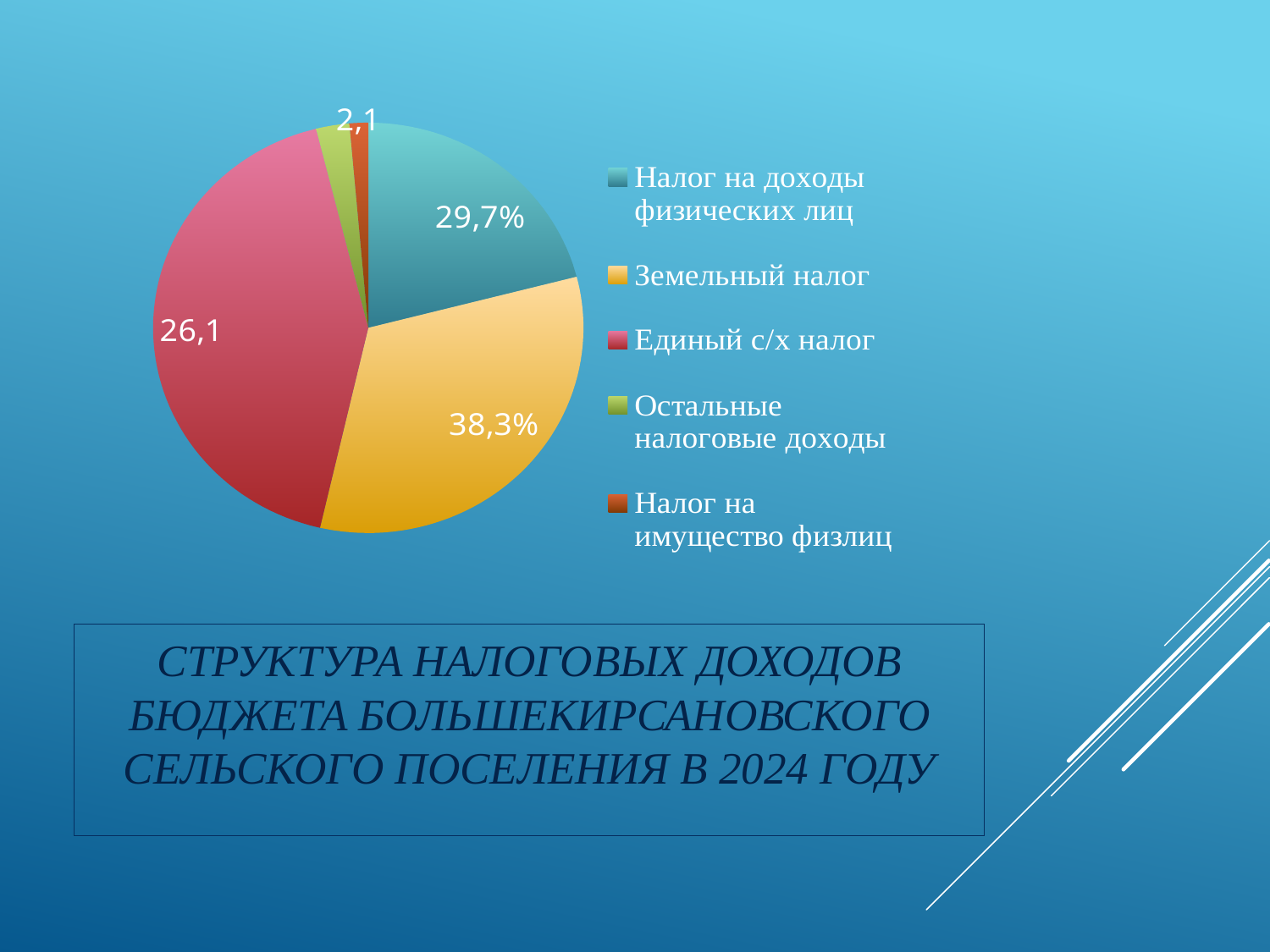
Which year does the chart title say the tax revenue structure refers to? 2024 Which category has the largest slice of the pie? Единый с/х налог What is the value shown for Налог на доходы физических лиц? 29,7% What kind of chart is shown on the slide? pie chart What is the value shown for Земельный налог? 38,3% What colour is the slice for Единый с/х налог? red How many categories does the pie chart have? 5 What is the difference between the values for Земельный налог and Налог на доходы физических лиц? 8,6 What is the value shown for Единый с/х налог? 26,1 Which is larger: Земельный налог or Налог на доходы физических лиц? Земельный налог How many entries does the legend list? 5